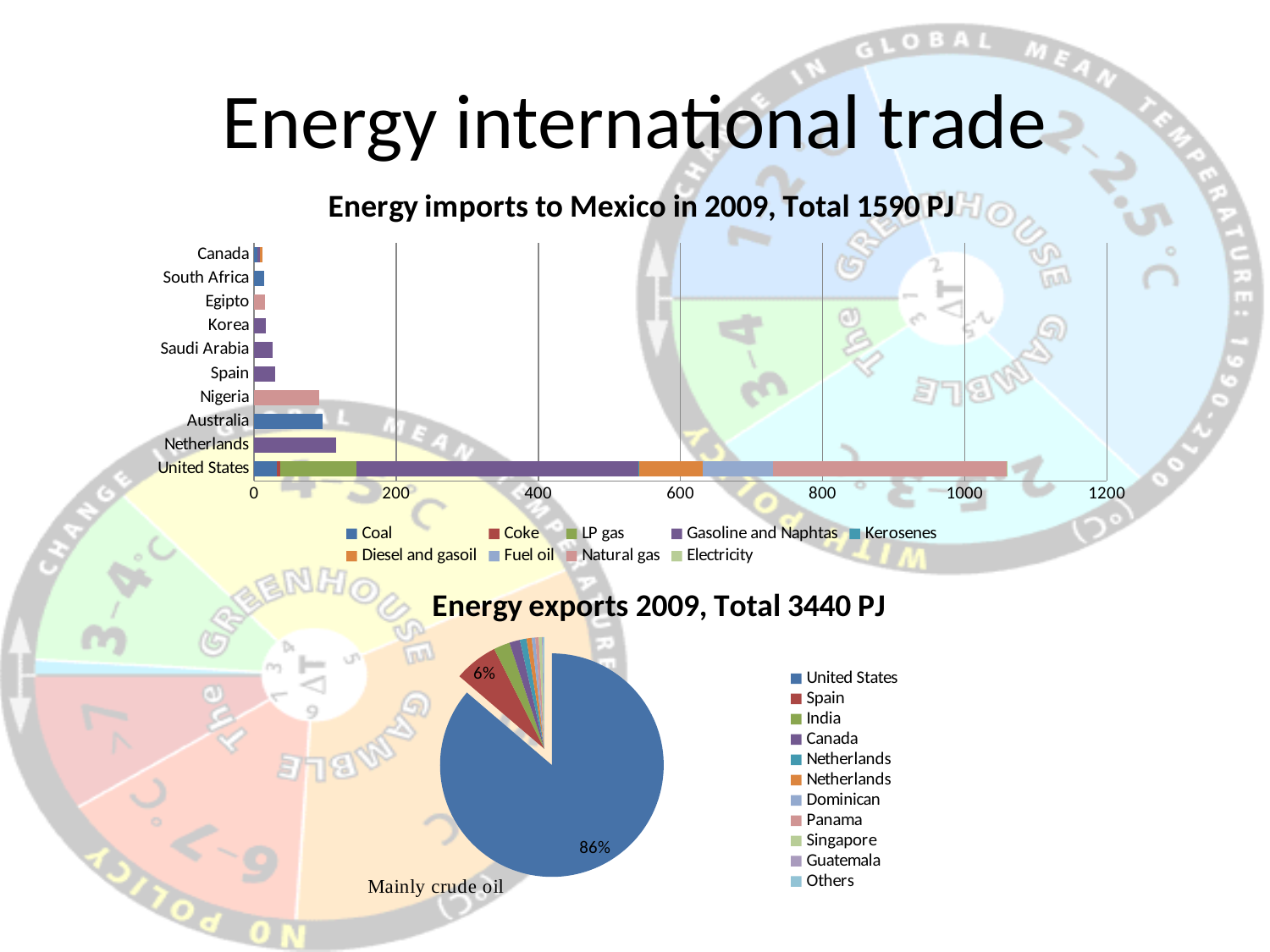
In the 'Energy exports 2009' pie chart, how many percentage points larger is the United States share than the Spain share? 80 According to the title of the 'Energy exports 2009' chart, what is the total energy exported? 3440 PJ In the 'Energy imports to Mexico in 2009' chart, is the total bar for United States greater or less than 1000? greater In the 'Energy imports to Mexico in 2009' chart, how many series does the legend list? 9 In the 'Energy imports to Mexico in 2009' chart, which country has the longest bar? United States In the 'Energy imports to Mexico in 2009' chart, which bar is longer, Netherlands or Australia? Netherlands In the 'Energy imports to Mexico in 2009' chart, is the bar for Netherlands greater or less than 200? less What kind of chart is the 'Energy imports to Mexico in 2009' chart? bar chart In the 'Energy imports to Mexico in 2009' chart, how many countries are listed on the vertical axis? 10 In the 'Energy exports 2009' pie chart, what share does Spain have? 6% In the 'Energy exports 2009' pie chart, what share does United States have? 86% What kind of chart is the 'Energy exports 2009' chart? pie chart